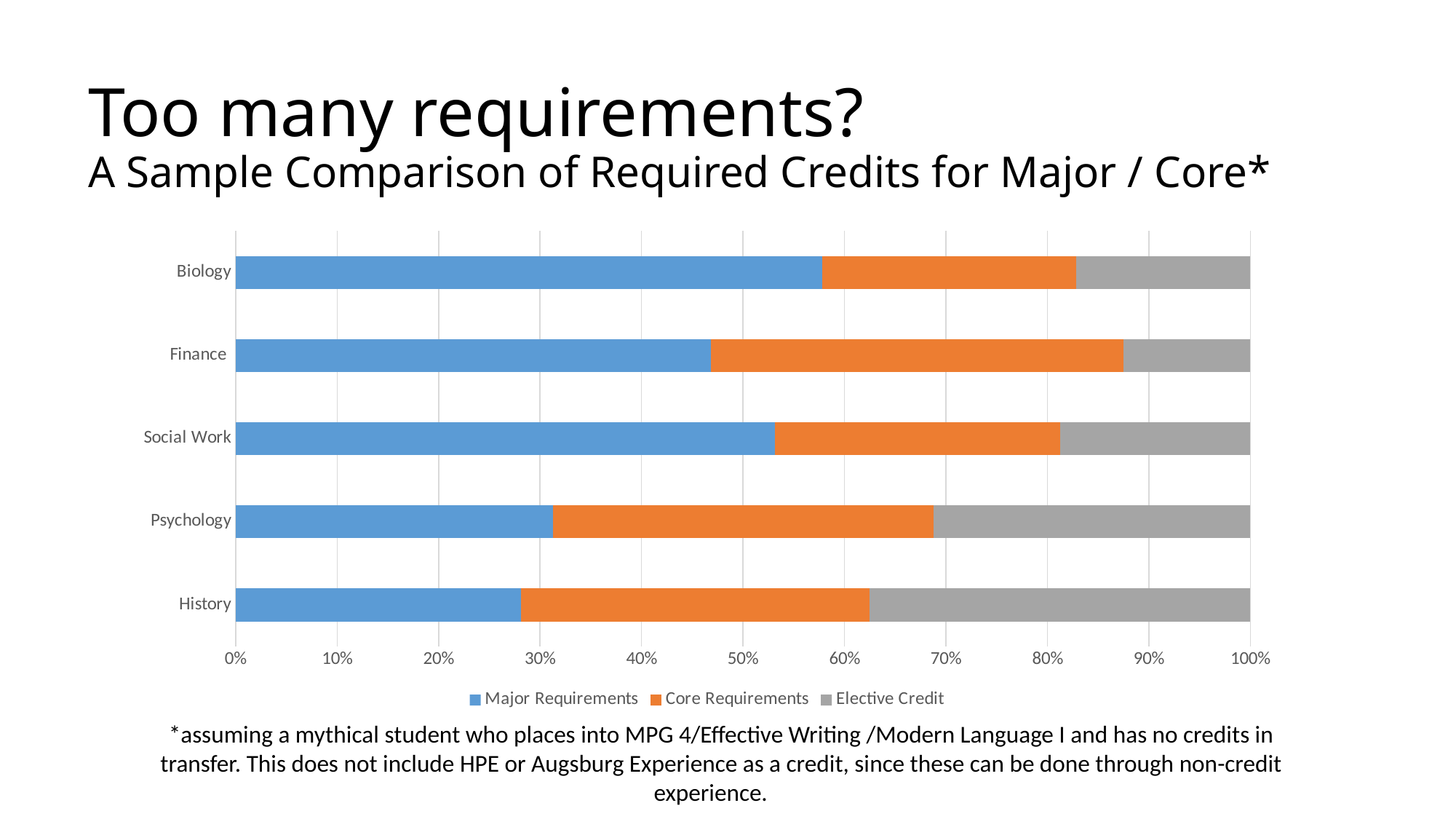
Which major has the smallest share of Elective Credit? Finance Which has a larger Major Requirements share, Biology or Finance? Biology What kind of chart is shown on the slide? Stacked bar chart How many series does the legend list? 3 Is the Major Requirements share for History greater or less than 30%? less Which major has the smallest share of Major Requirements? History Is the Major Requirements share for Finance greater or less than 50%? less Which major has the largest share of Elective Credit? History Which major has the largest share of Major Requirements? Biology How many majors (categories) are plotted on the chart? 5 Which colour represents Core Requirements in the chart? Orange Is the Major Requirements share for Biology greater or less than 50%? greater